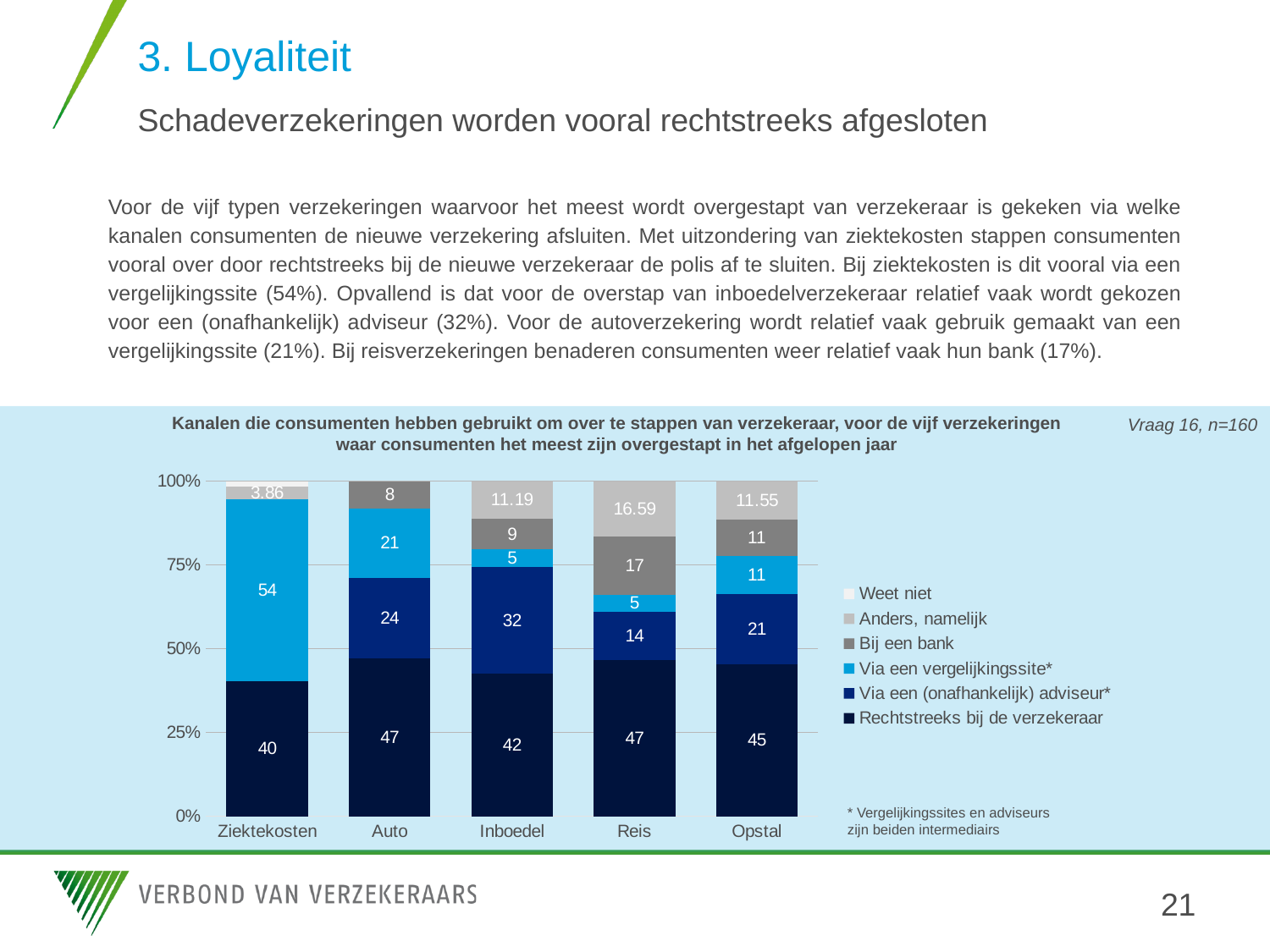
What kind of chart is shown on the slide? Stacked bar chart Which insurance type has the lowest value for 'Rechtstreeks bij de verzekeraar'? Ziektekosten What is the value for 'Rechtstreeks bij de verzekeraar' for Inboedel? 42 What is the survey question number and sample size noted next to the chart? Vraag 16, n=160 What percentage of consumers switched their Ziektekosten insurance via a comparison site (Via een vergelijkingssite*)? 54 What is the value for 'Anders, namelijk' for Opstal? 11.55 Which is larger: the 'Via een (onafhankelijk) adviseur*' value for Inboedel or for Auto? Inboedel What is the difference between the 'Via een vergelijkingssite*' values for Ziektekosten and Auto? 33 How many series does the chart legend list? 6 How many insurance types are shown on the x axis of the chart? 5 What is the value for 'Bij een bank' for Reis? 17 Which insurance type has the highest value for 'Via een (onafhankelijk) adviseur*'? Inboedel